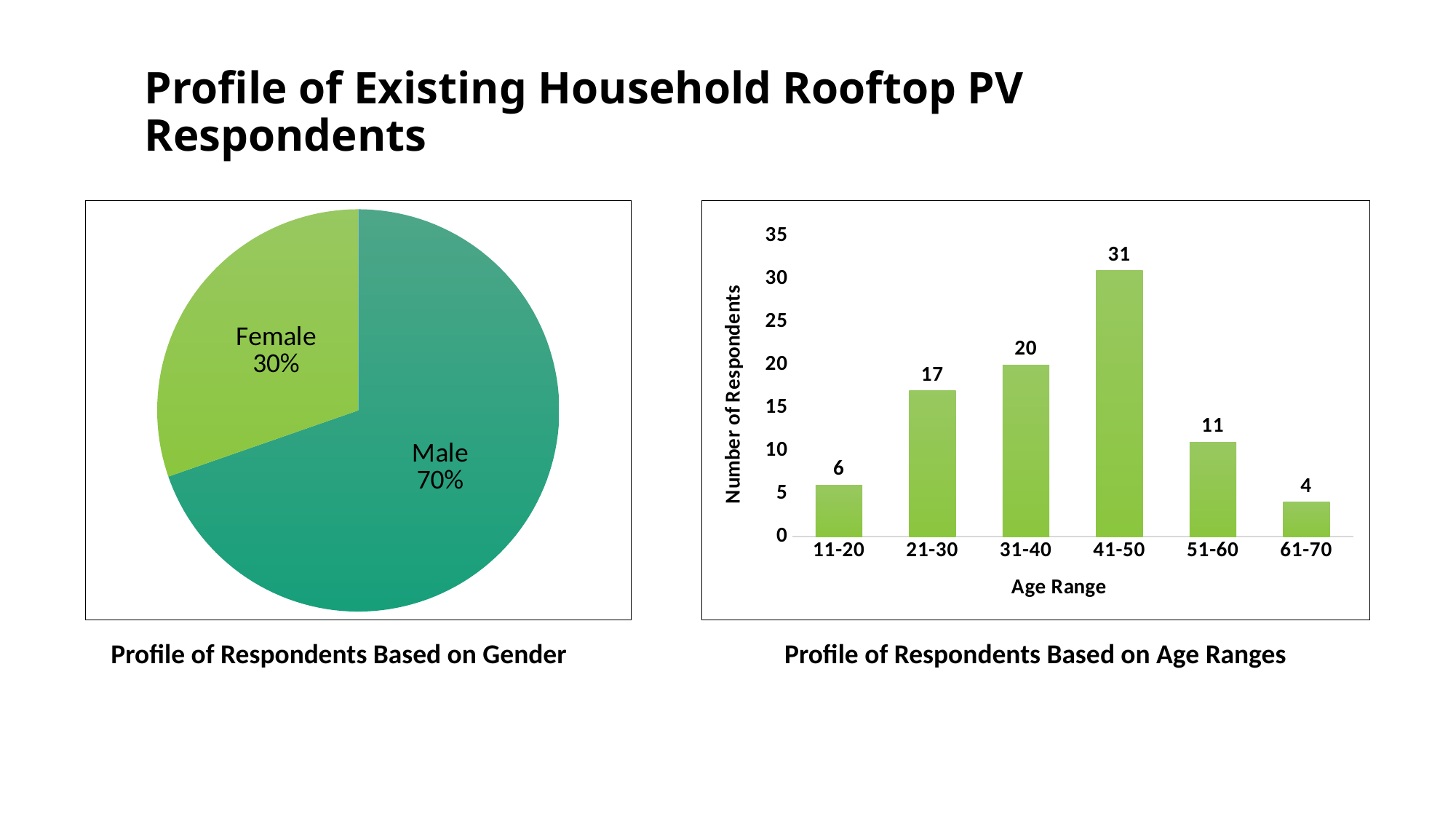
In the 'Profile of Respondents Based on Age Ranges' chart, how many respondents are in the 41-50 age range? 31 In the 'Profile of Respondents Based on Age Ranges' chart, which has more respondents, 21-30 or 51-60? 21-30 In the 'Profile of Respondents Based on Age Ranges' chart, which age range has the highest number of respondents? 41-50 What kind of chart is 'Profile of Respondents Based on Age Ranges'? Bar chart In the 'Profile of Respondents Based on Age Ranges' chart, which age range has the lowest number of respondents? 61-70 In the 'Profile of Respondents Based on Age Ranges' chart, what is the difference in respondents between the 41-50 and 31-40 age ranges? 11 In the 'Profile of Respondents Based on Gender' pie chart, what share of respondents is Female? 30% In the 'Profile of Respondents Based on Gender' pie chart, what share of respondents is Male? 70% How many age ranges are shown in the 'Profile of Respondents Based on Age Ranges' chart? 6 What is the y-axis label of the 'Profile of Respondents Based on Age Ranges' chart? Number of Respondents In the 'Profile of Respondents Based on Age Ranges' chart, how many respondents are in the 11-20 age range? 6 What kind of chart is 'Profile of Respondents Based on Gender'? Pie chart